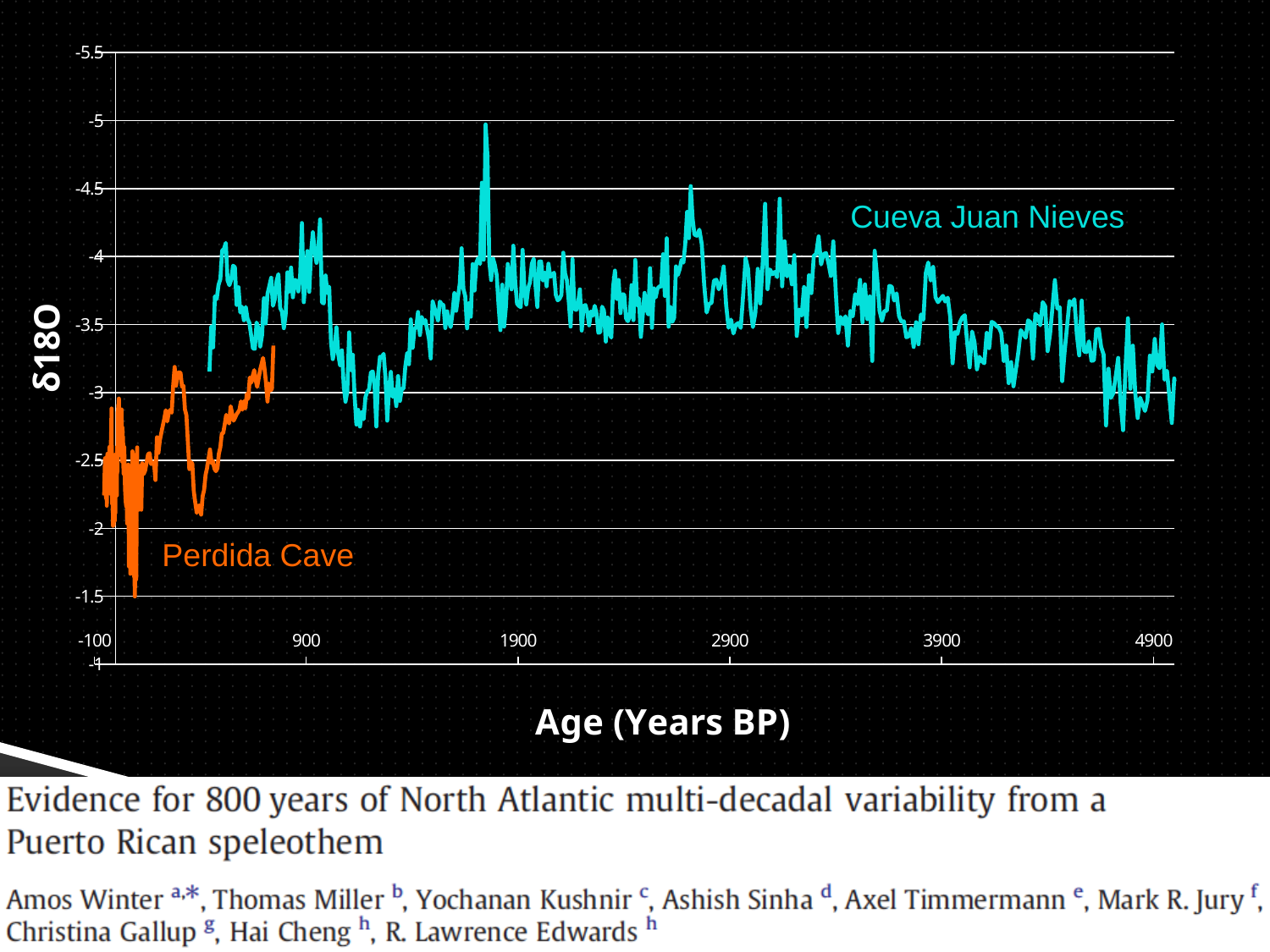
Does the Cueva Juan Nieves series ever reach a δ18O value below -4.5? yes Which series is drawn in orange? Perdida Cave What is the label of the y axis? δ18O Which series extends to the oldest ages (largest Years BP) on the x axis? Cueva Juan Nieves What is the smallest age value labelled on the x axis? -100 What kind of chart is shown on the slide? line chart How many data series are plotted on the chart? 2 What is the label of the x axis? Age (Years BP) Moving from -100 toward 900 years BP, does the Perdida Cave series move toward more negative or less negative δ18O values overall? more negative Which series covers the period around 2900 years BP? Cueva Juan Nieves Does the Perdida Cave series ever reach a δ18O value above -2? yes What is the largest age value labelled on the x axis? 4900